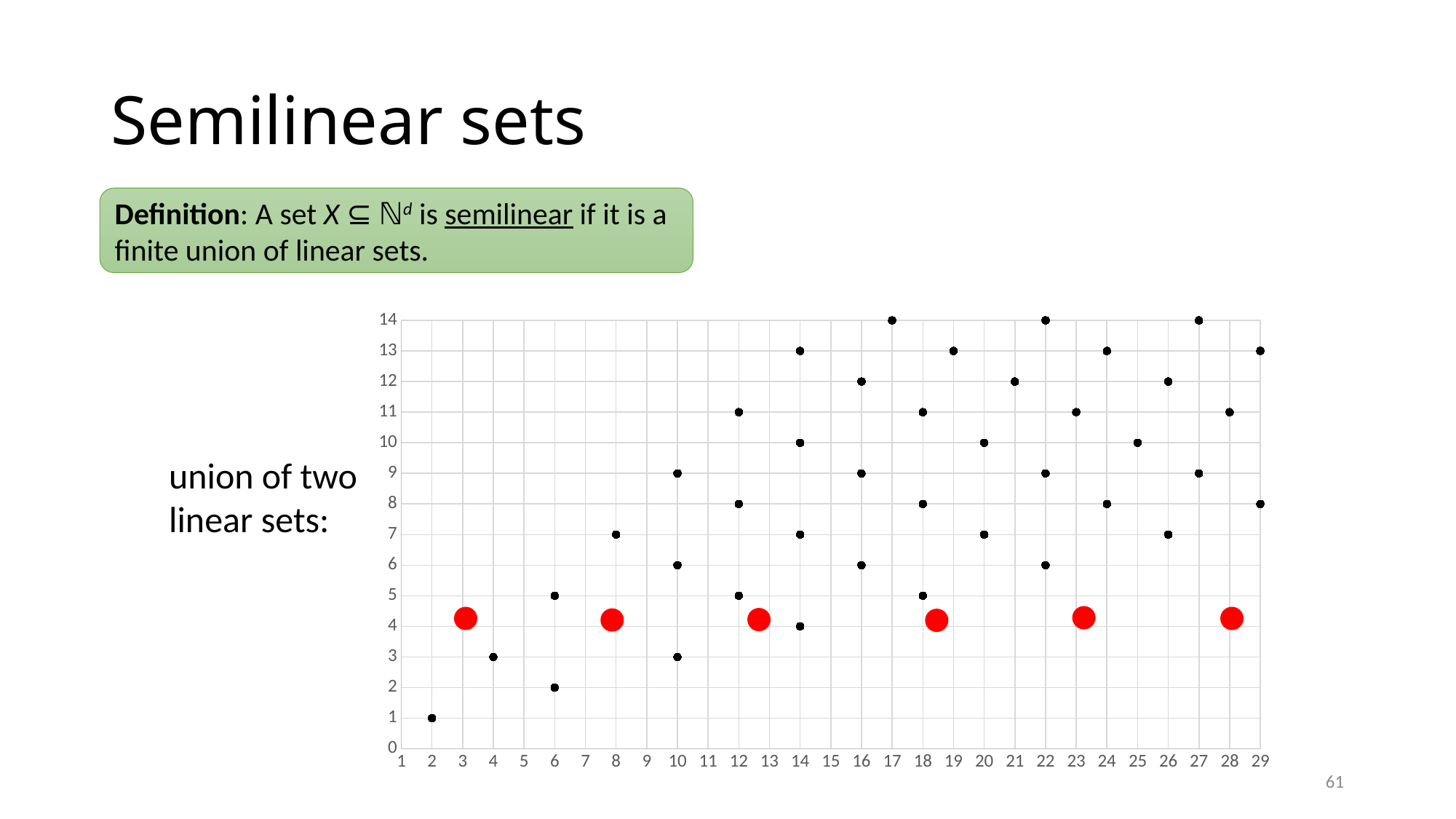
At which x values do the large red points appear? 3, 8, 13, 18, 23, 28 What kind of chart is shown on the slide? scatter chart What is the y value of the black point at x = 8? 7 What is the y value of the black point at x = 4? 3 Is the y value of the black point at x = 17 greater or less than 10? greater What is the largest value labelled on the x axis? 29 Which has the larger y value: the black point at x = 8 or the black point at x = 4? x = 8 What is the difference between the y value of the black point at x = 8 and the black point at x = 4? 4 How many black points are plotted at x = 10? 3 What is the y value of the black point at x = 2? 1 How many large red points are plotted on the chart? 6 What is the highest y value reached by any plotted point? 14